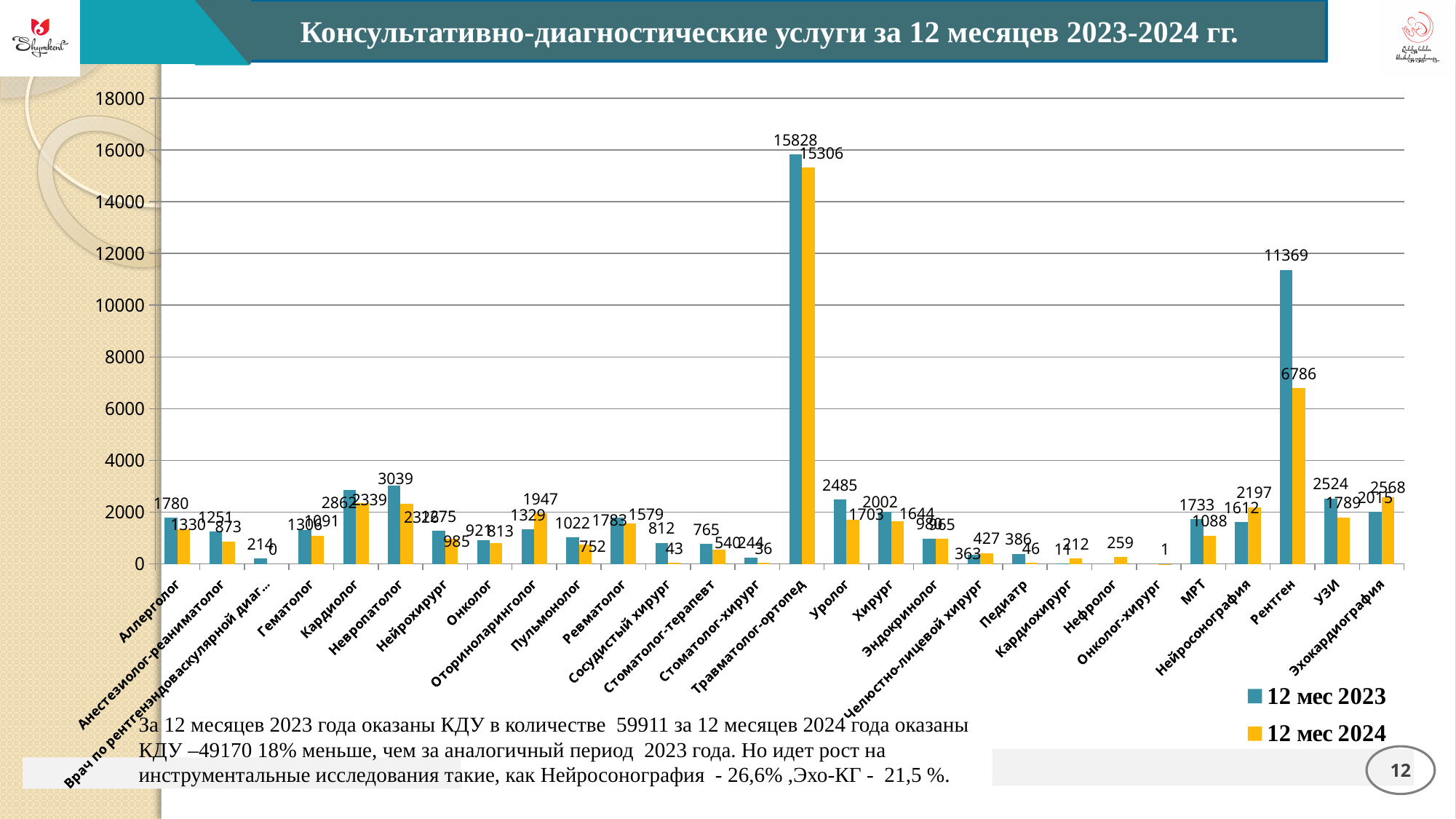
What is the difference between the 12 мес 2023 and 12 мес 2024 values for Травматолог-ортопед? 522 What is the value for Рентген in the 12 мес 2024 series? 6786 What is the value for Эхокардиография in the 12 мес 2024 series? 2568 How many series does the legend list? 2 For Нейросонография, which series has the larger value, 12 мес 2023 or 12 мес 2024? 12 мес 2024 What is the value for Уролог in the 12 мес 2023 series? 2485 Which category has the highest value in the 12 мес 2023 series? Травматолог-ортопед What is the difference between the 12 мес 2023 and 12 мес 2024 values for Рентген? 4583 Is the value for Рентген in the 12 мес 2023 series greater or less than 10000? greater What is the value for Травматолог-ортопед in the 12 мес 2023 series? 15828 What kind of chart is shown on the slide? bar chart What is the title of the chart? Консультативно-диагностические услуги за 12 месяцев 2023-2024 гг.